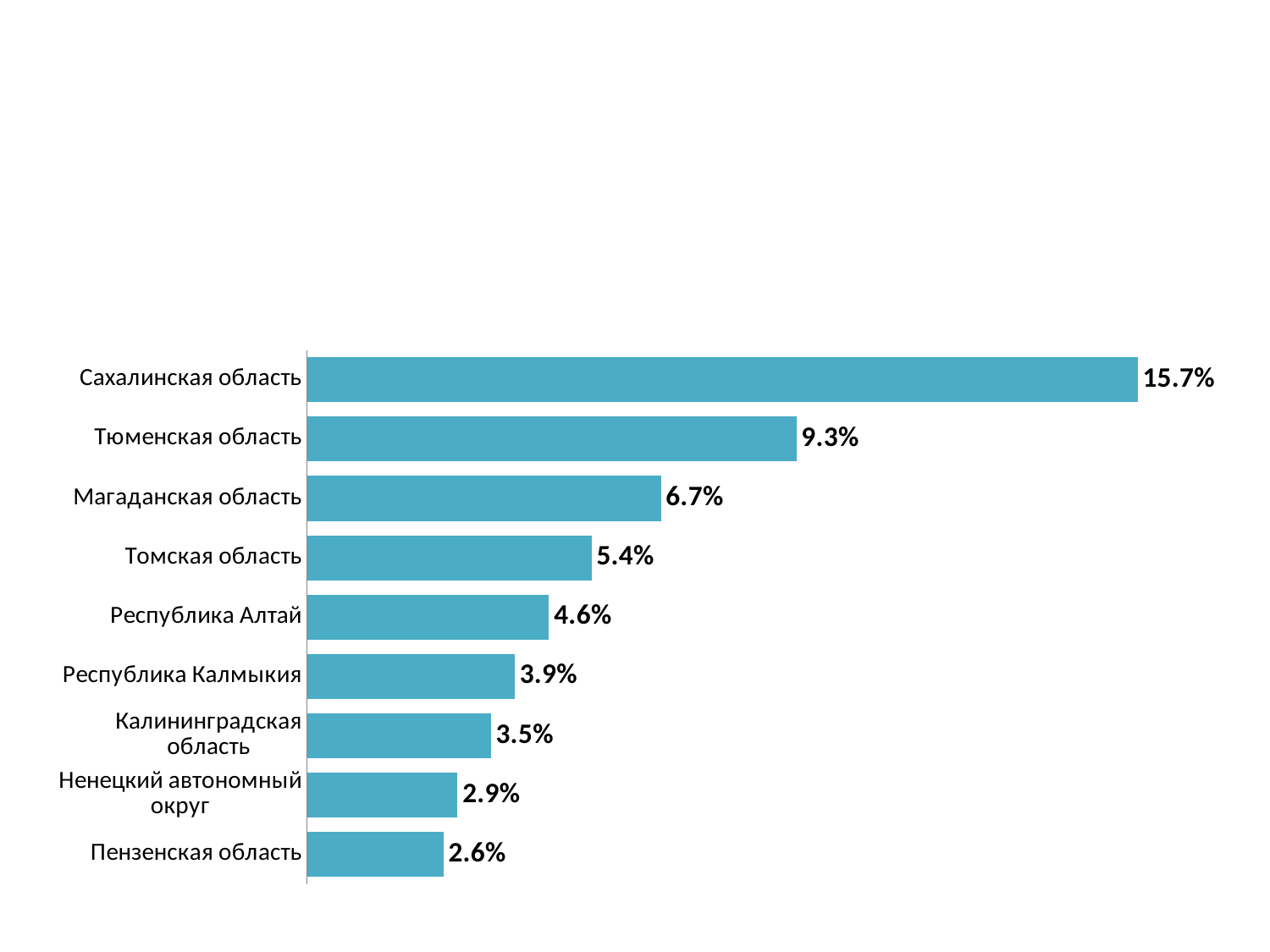
Which category has the highest value? Сахалинская область What is the difference between the values for Магаданская область and Республика Алтай? 2.1% What is the difference between the values for Сахалинская область and Тюменская область? 6.4% What is the value for Республика Калмыкия? 3.9% Which is larger, the value for Калининградская область or the value for Пензенская область? Калининградская область Which category has the lowest value? Пензенская область What is the value for Ненецкий автономный округ? 2.9% How many categories are shown in the chart? 9 What is the value for Томская область? 5.4% What kind of chart is shown on the slide? Bar chart What is the value for Сахалинская область? 15.7% What colour are the bars in the chart? Blue